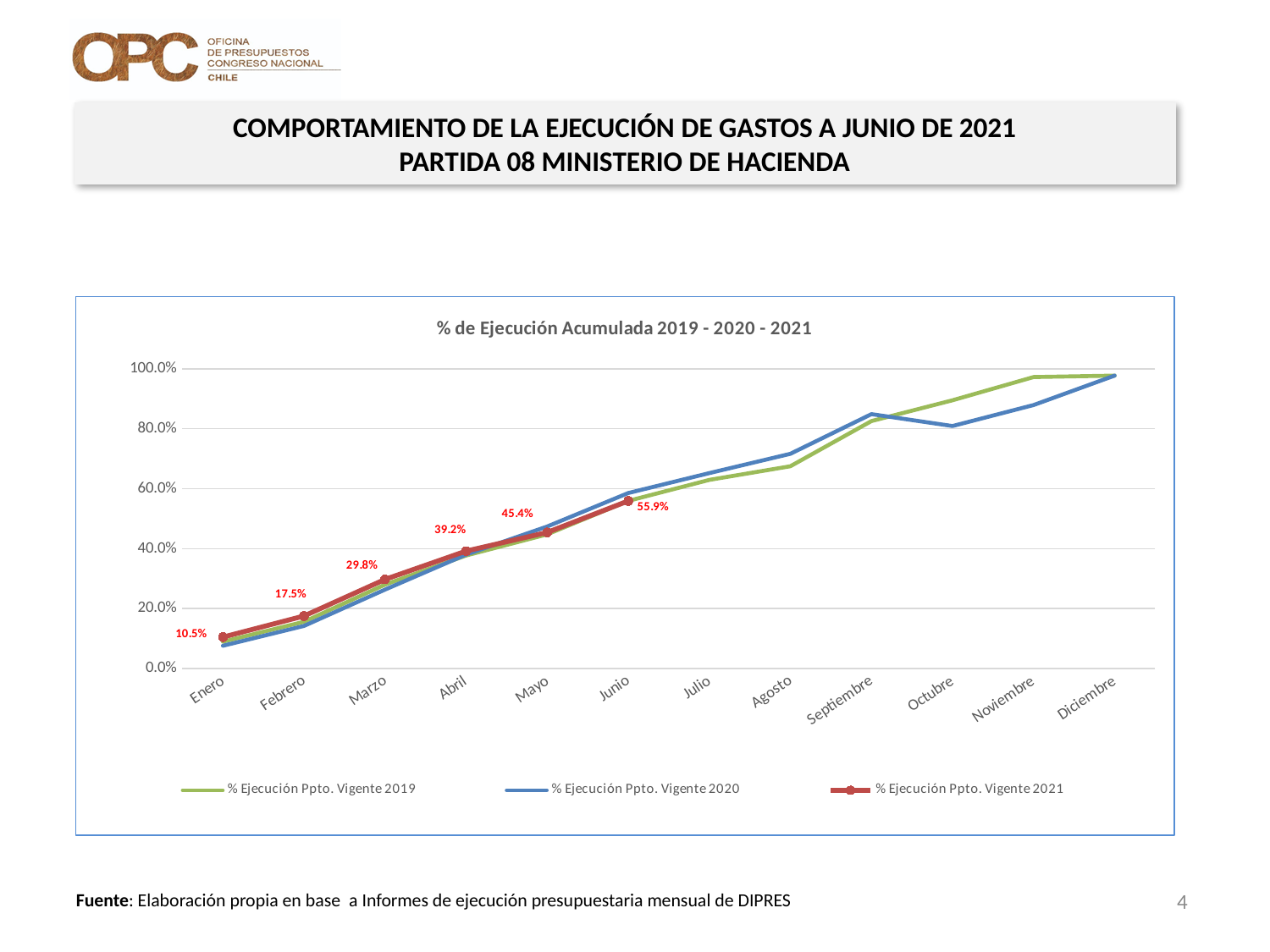
In Octubre, which series has the larger value: % Ejecución Ppto. Vigente 2019 or % Ejecución Ppto. Vigente 2020? % Ejecución Ppto. Vigente 2019 What is the difference between the 2021 values for Junio and Enero? 45.4% Is the value for % Ejecución Ppto. Vigente 2019 in Agosto greater or less than 80.0%? less How many months are shown on the x axis? 12 What is the value for % Ejecución Ppto. Vigente 2021 in Marzo? 29.8% What is the value for % Ejecución Ppto. Vigente 2021 in Junio? 55.9% Among the labeled 2021 points, which month has the highest value? Junio What is the title of the chart? % de Ejecución Acumulada 2019 - 2020 - 2021 What type of chart is shown on the slide? line chart How many series does the legend list? 3 What is the value for % Ejecución Ppto. Vigente 2021 in Enero? 10.5% Does the % Ejecución Ppto. Vigente 2021 series rise or fall from Enero to Junio? rise